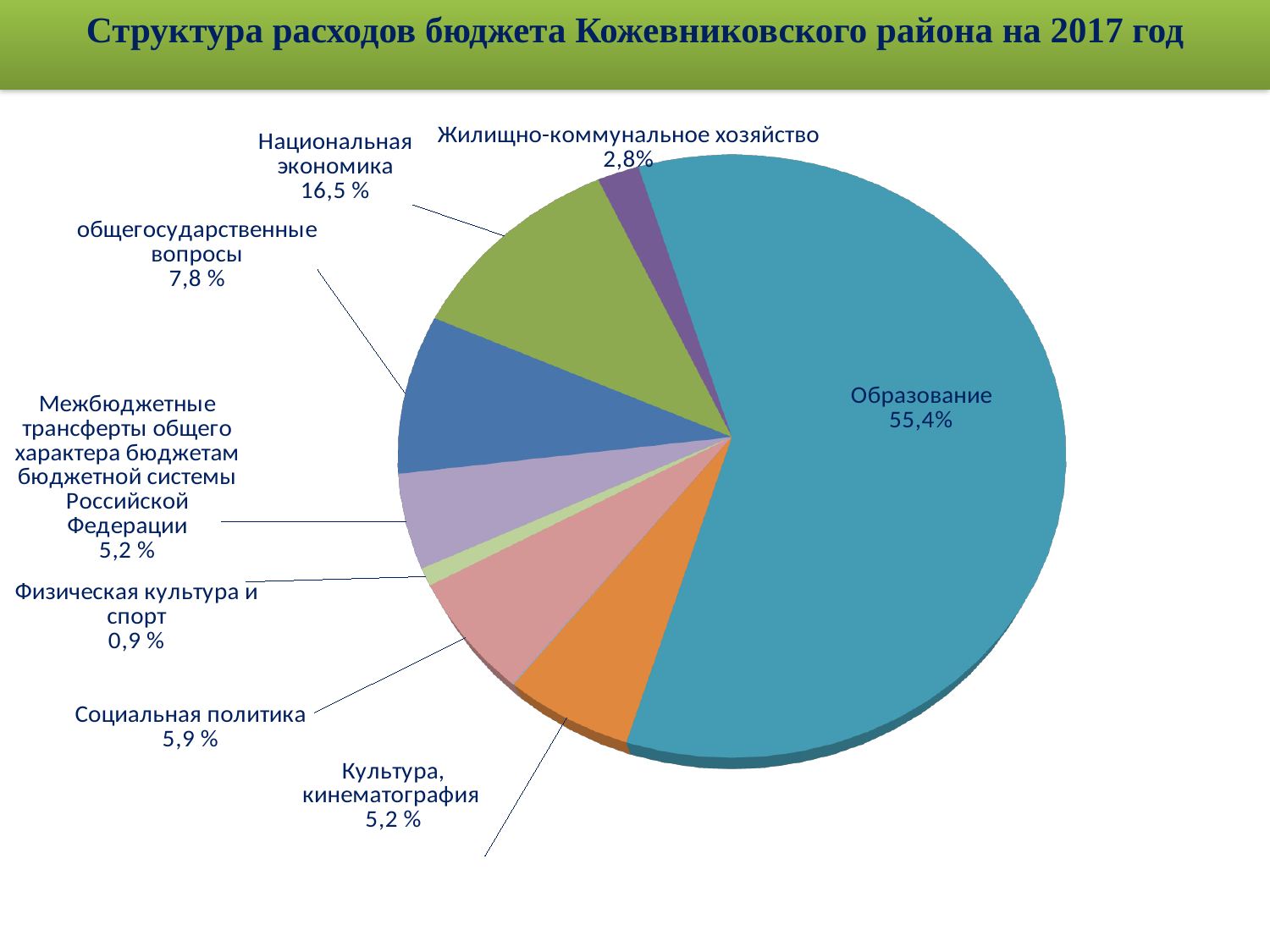
Which category has the smallest share of the budget expenditures? Физическая культура и спорт What is the share of Национальная экономика? 16,5 % Which category has the largest share of the budget expenditures? Образование What is the title of the slide? Структура расходов бюджета Кожевниковского района на 2017 год What is the share of Образование in the pie chart? 55,4% What is the share of Жилищно-коммунальное хозяйство? 2,8% What is the share of общегосударственные вопросы? 7,8 % Which is larger: the share of общегосударственные вопросы or the share of Социальная политика? общегосударственные вопросы What is the difference in percentage points between Образование and Национальная экономика? 38,9 What kind of chart is shown on the slide? pie chart What is the share of Социальная политика? 5,9 %